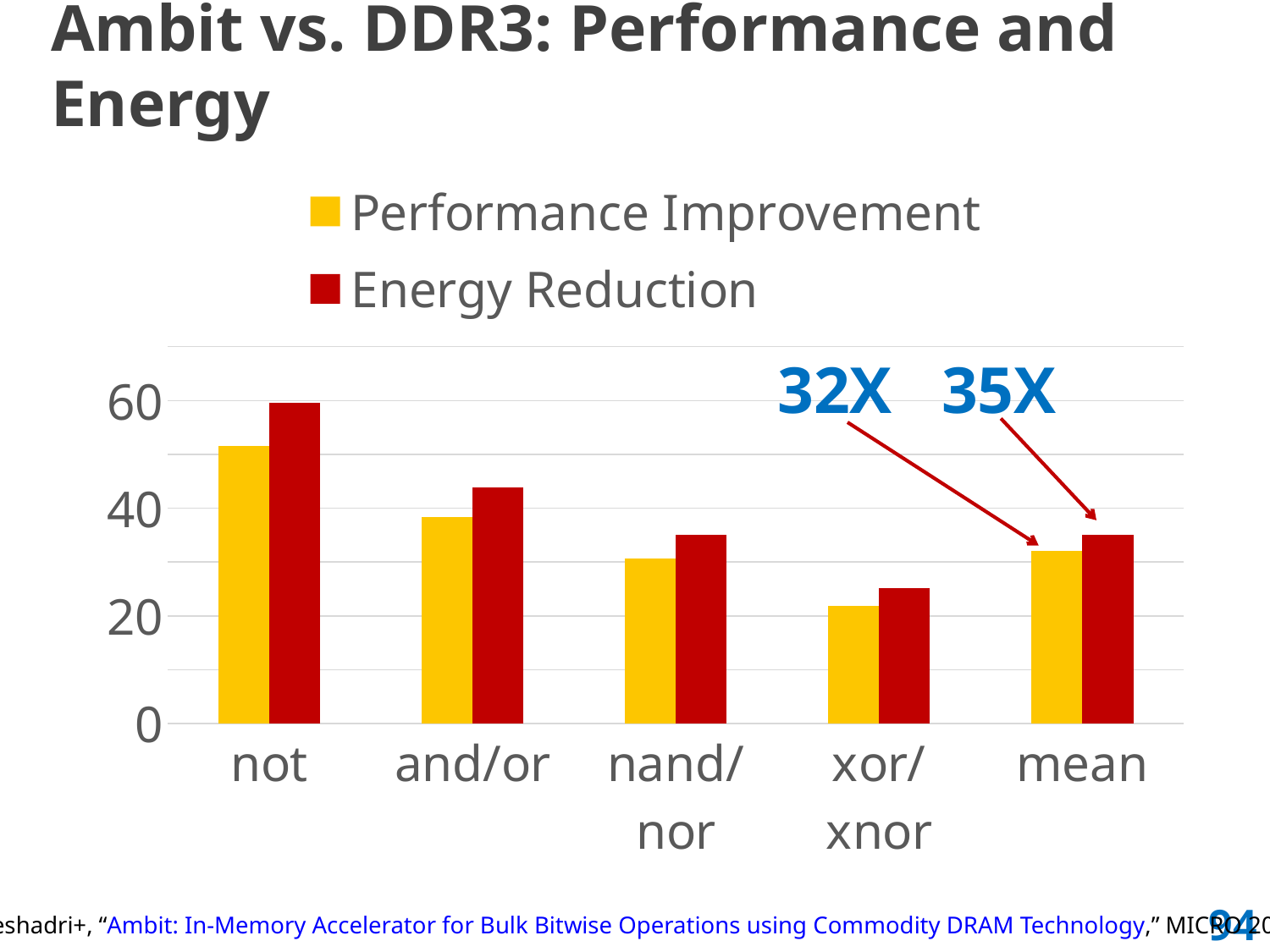
Which operation has the lowest Energy Reduction? xor/xnor What is the mean Performance Improvement shown on the chart? 32X What is the mean Energy Reduction shown on the chart? 35X Is the Performance Improvement for 'xor/xnor' greater or less than 40? less Which operation has the highest Performance Improvement? not Do the Performance Improvement values rise or fall from 'not' to 'xor/xnor'? fall For the 'not' operation, which is larger: Performance Improvement or Energy Reduction? Energy Reduction What kind of chart is shown on the slide? bar chart How many categories are shown on the x axis? 5 How many series does the legend list? 2 Is the Energy Reduction for 'not' greater or less than 40? greater What is the difference between the mean Energy Reduction and the mean Performance Improvement? 3X